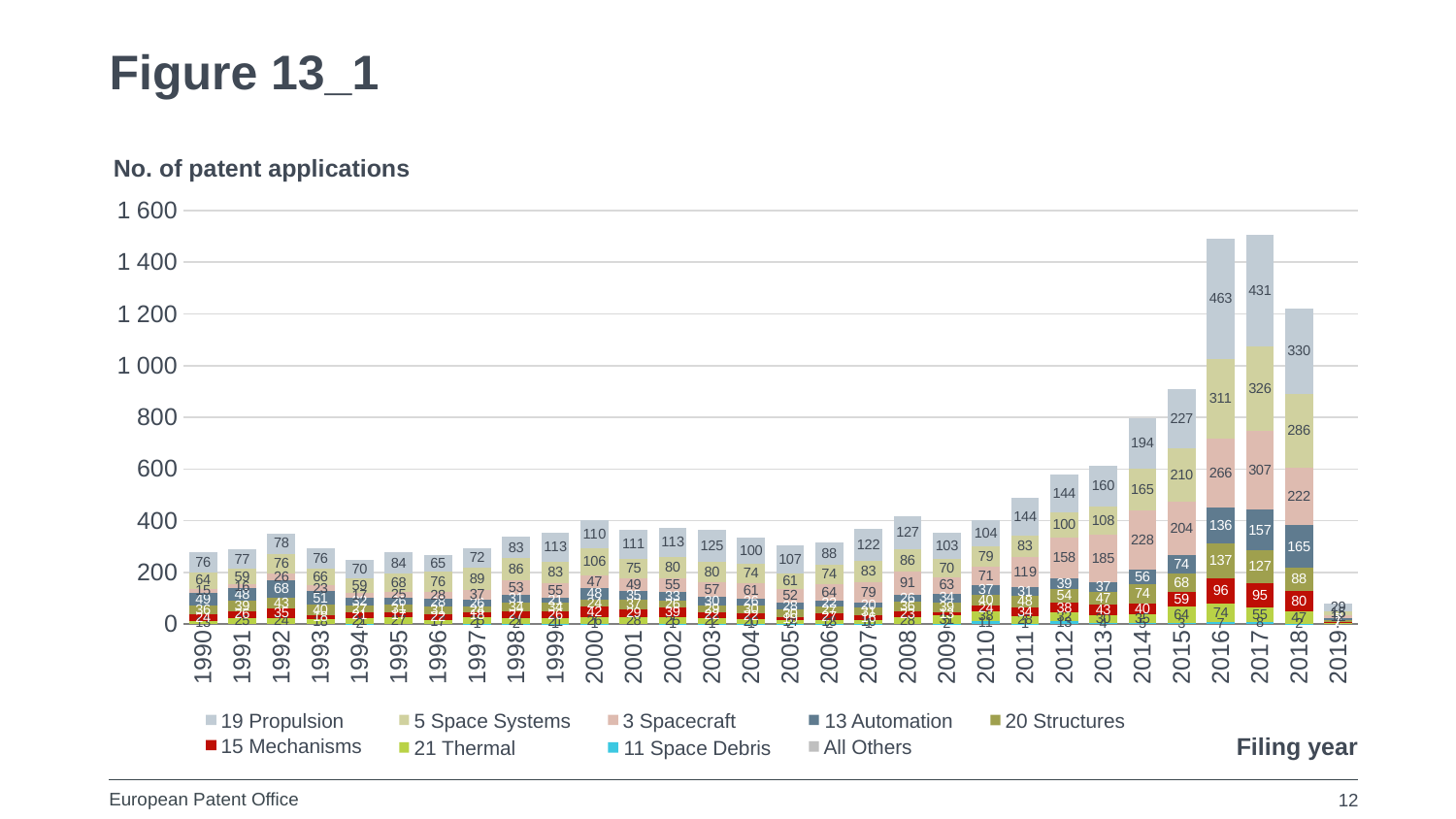
What is the value of the 13 Automation segment for filing year 2018? 165 What is the value of the 5 Space Systems segment for filing year 2017? 326 Which filing year has the larger 3 Spacecraft value, 2016 or 2017? 2017 Which filing year has the highest 19 Propulsion value? 2016 What is the label on the x axis of the chart? Filing year What is the value of the 3 Spacecraft segment for filing year 2018? 222 What kind of chart is shown on the slide? Stacked bar chart How many filing years are shown on the x axis? 30 How many series does the legend list? 9 What is the difference between the 19 Propulsion values for 2016 and 2017? 32 Is the total number of patent applications for filing year 2015 greater or less than 800? greater What is the value of the 19 Propulsion segment for filing year 2016? 463